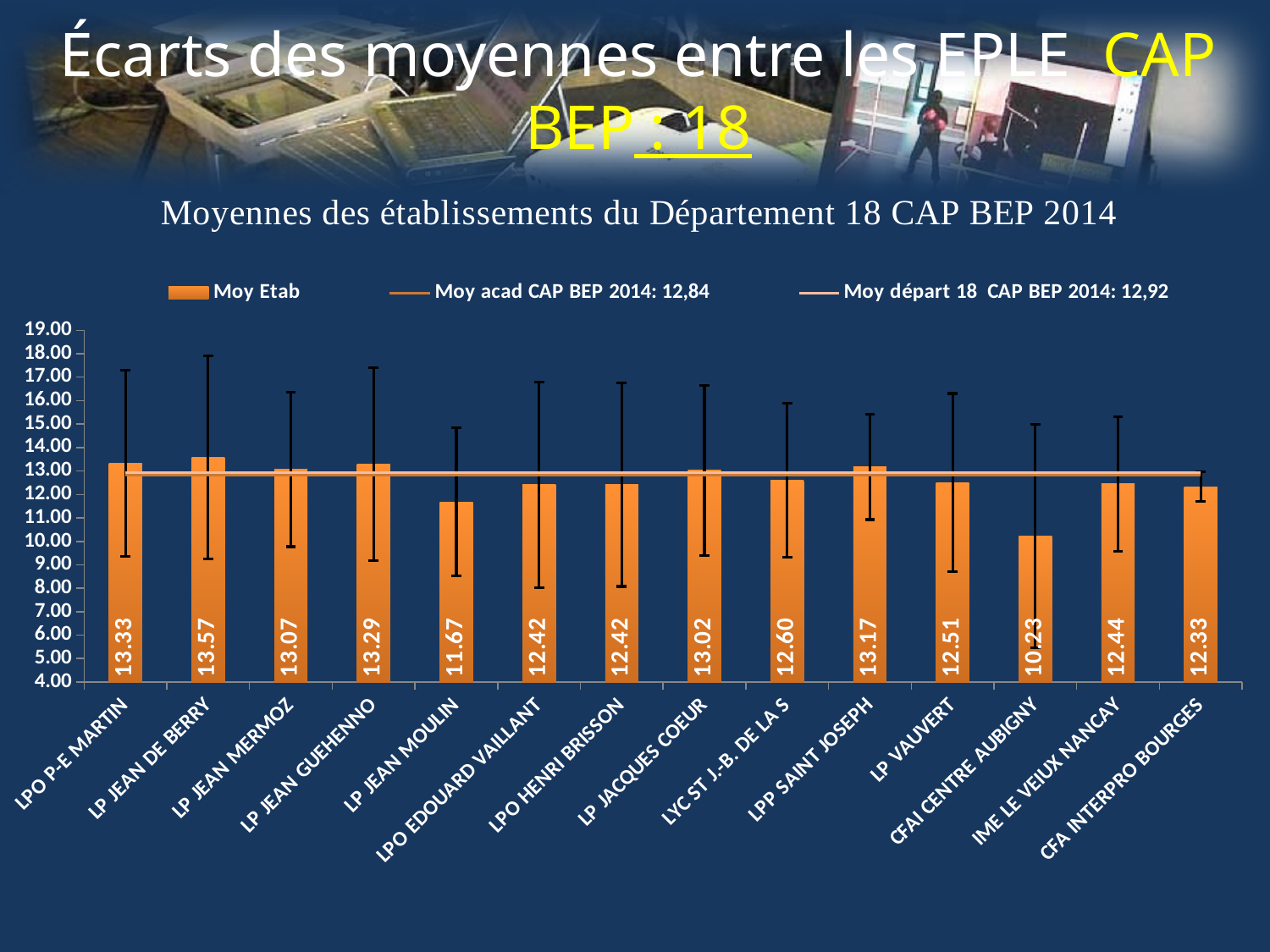
Is the value for CFAI CENTRE AUBIGNY greater or less than 11.00? less What is the value for CFA INTERPRO BOURGES? 12.33 What is the difference between the values for LP JEAN DE BERRY and CFAI CENTRE AUBIGNY? 3.34 What is the value for LP JEAN MOULIN? 11.67 What is the value for LPP SAINT JOSEPH? 13.17 How many series does the legend list? 3 Which establishment has the highest value? LP JEAN DE BERRY Which is larger, the value for LPO P-E MARTIN or the value for LP JEAN MERMOZ? LPO P-E MARTIN How many establishments are shown on the x axis? 14 What kind of chart is this? bar chart Which establishment has the lowest value? CFAI CENTRE AUBIGNY What value does the legend give for Moy acad CAP BEP 2014? 12,84